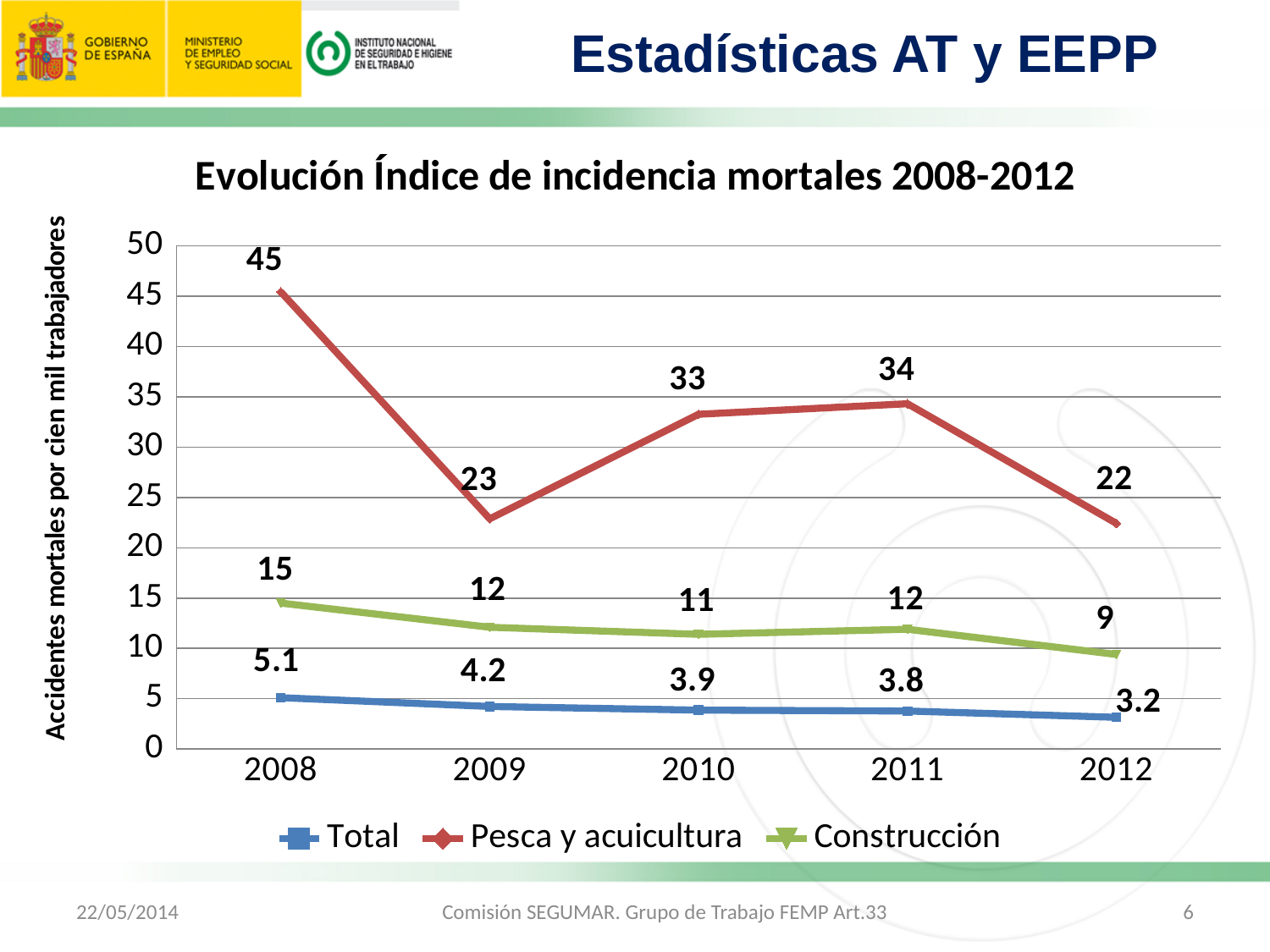
What is the value for Total in 2012? 3.2 What is the difference between the Pesca y acuicultura values in 2008 and 2009? 22 What is the value for Pesca y acuicultura in 2008? 45 What is the difference between the Total values in 2008 and 2012? 1.9 Which is larger, the Pesca y acuicultura value in 2010 or in 2011? 2011 How many series does the legend list? 3 What is the value for Construcción in 2010? 11 In which year is the Construcción value highest? 2008 Does the Total series rise or fall from 2008 to 2012? fall What kind of chart is shown? line chart How many years are shown on the x axis? 5 In which year is the Pesca y acuicultura value lowest? 2012